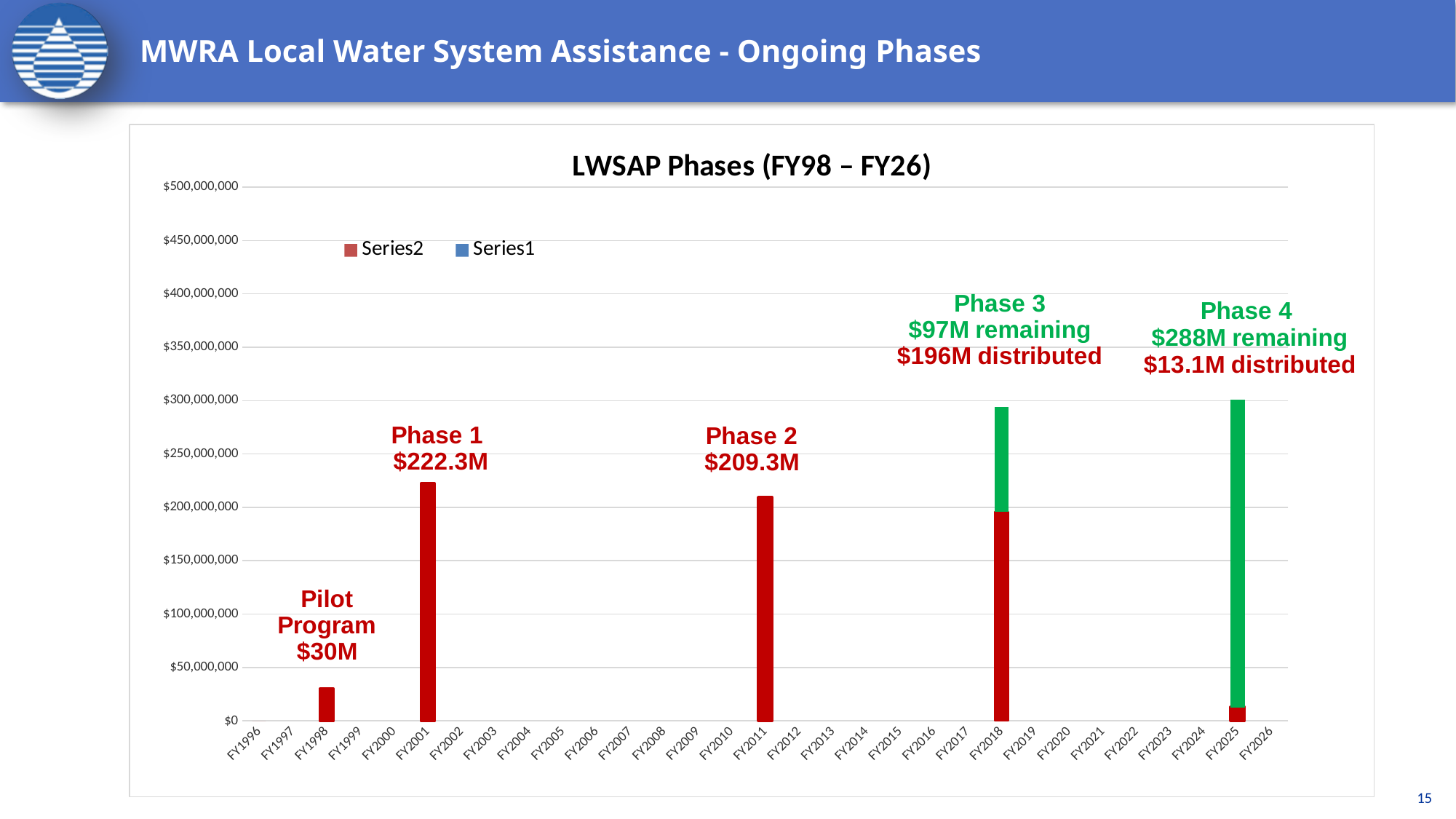
What is the total of the Phase 3 bar (distributed plus remaining)? $293M Is the Phase 1 bar greater or less than $200,000,000? greater Which is larger, the Phase 1 amount or the Phase 2 amount? Phase 1 How much remains in Phase 3 according to the chart annotation? $97M What is the amount shown for the Pilot Program? $30M What is the amount shown for Phase 1 in the LWSAP Phases chart? $222.3M What is the difference between the Phase 1 amount and the Phase 2 amount? $13M Which phase has the largest distributed (red) amount? Phase 1 How much has been distributed under Phase 4 according to the chart? $13.1M What type of chart is shown on the slide? Bar chart Which labelled program or phase has the smallest total bar in the chart? Pilot Program How many series does the legend list? 2